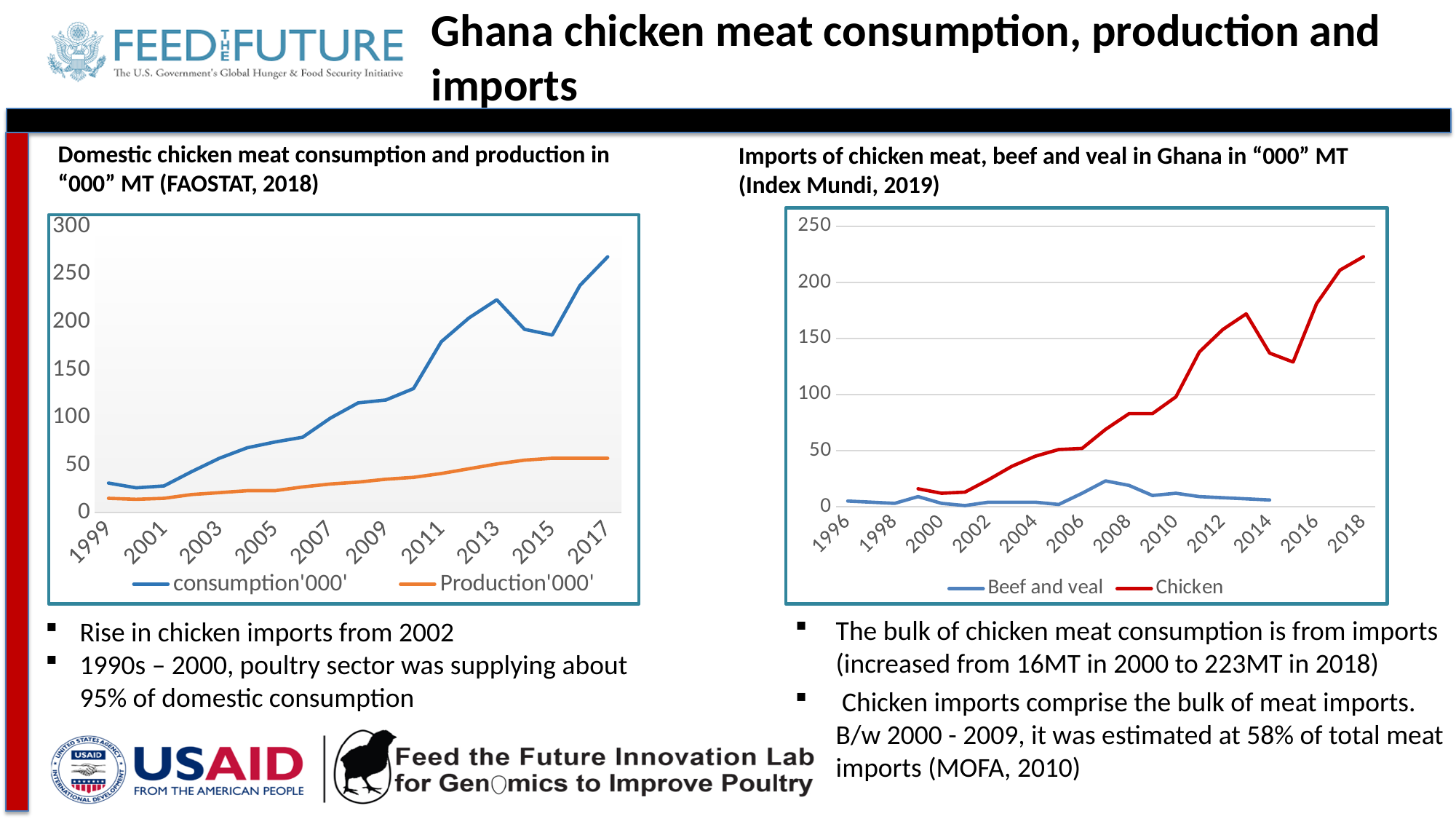
In the right chart, is the value for Beef and veal in 2008 greater or less than 50? less In the left chart, is the value for consumption'000' in 1999 greater or less than 50? less In the left chart, which series is larger in 2017, consumption'000' or Production'000'? consumption'000' In the right chart, is the value for Chicken in 2018 greater or less than 200? greater What kind of chart is the left chart, 'Domestic chicken meat consumption and production'? line chart In the right chart, which two series are listed in the legend? Beef and veal, Chicken In the right chart, which series is larger in 2014, Beef and veal or Chicken? Chicken How many series does the legend of the left chart list? 2 What kind of chart is the right chart, 'Imports of chicken meat, beef and veal in Ghana'? line chart In the left chart, does consumption'000' generally rise or fall from 1999 to 2017? rise